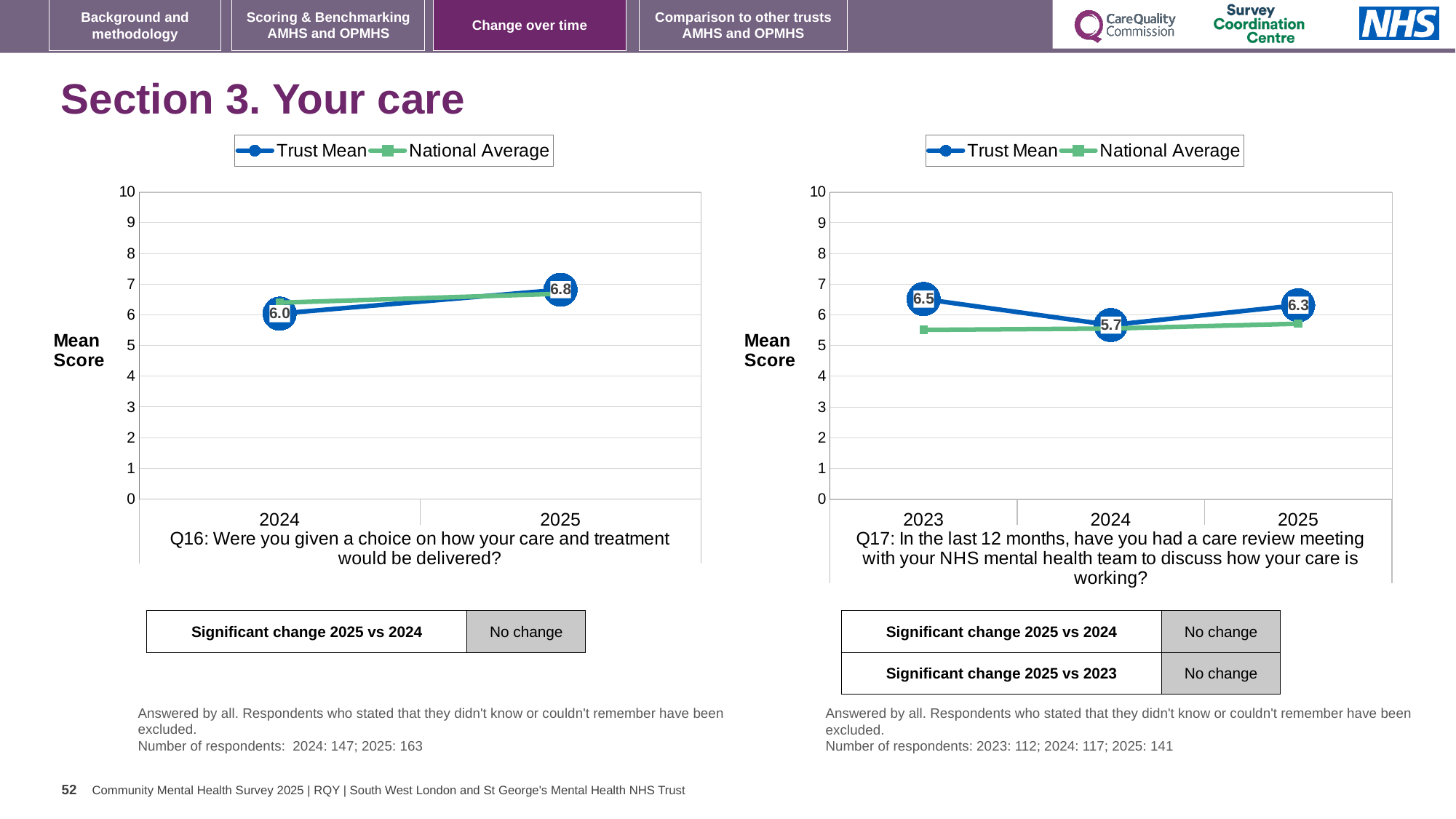
In the Q17 chart (right), what is the Trust Mean for 2024? 5.7 In the Q16 chart (left), does the Trust Mean rise or fall from 2024 to 2025? rise In the Q17 chart (right), what is the Trust Mean for 2023? 6.5 In the Q16 chart (left), by how much did the Trust Mean change from 2024 to 2025? 0.8 In the Q17 chart (right), what is the difference between the Trust Mean in 2023 and 2025? 0.2 How many years are plotted on the x axis of the Q17 chart (right)? 3 In the Q16 chart (left), what is the Trust Mean for 2025? 6.8 In the Q16 chart (left), what is the Trust Mean for 2024? 6.0 In the Q17 chart (right), which year has the highest Trust Mean? 2023 How many series does the legend of the Q16 chart (left) list? 2 In the Q17 chart (right), is the National Average for 2023 greater or less than 6? less In the Q17 chart (right), which year has the lowest Trust Mean? 2024